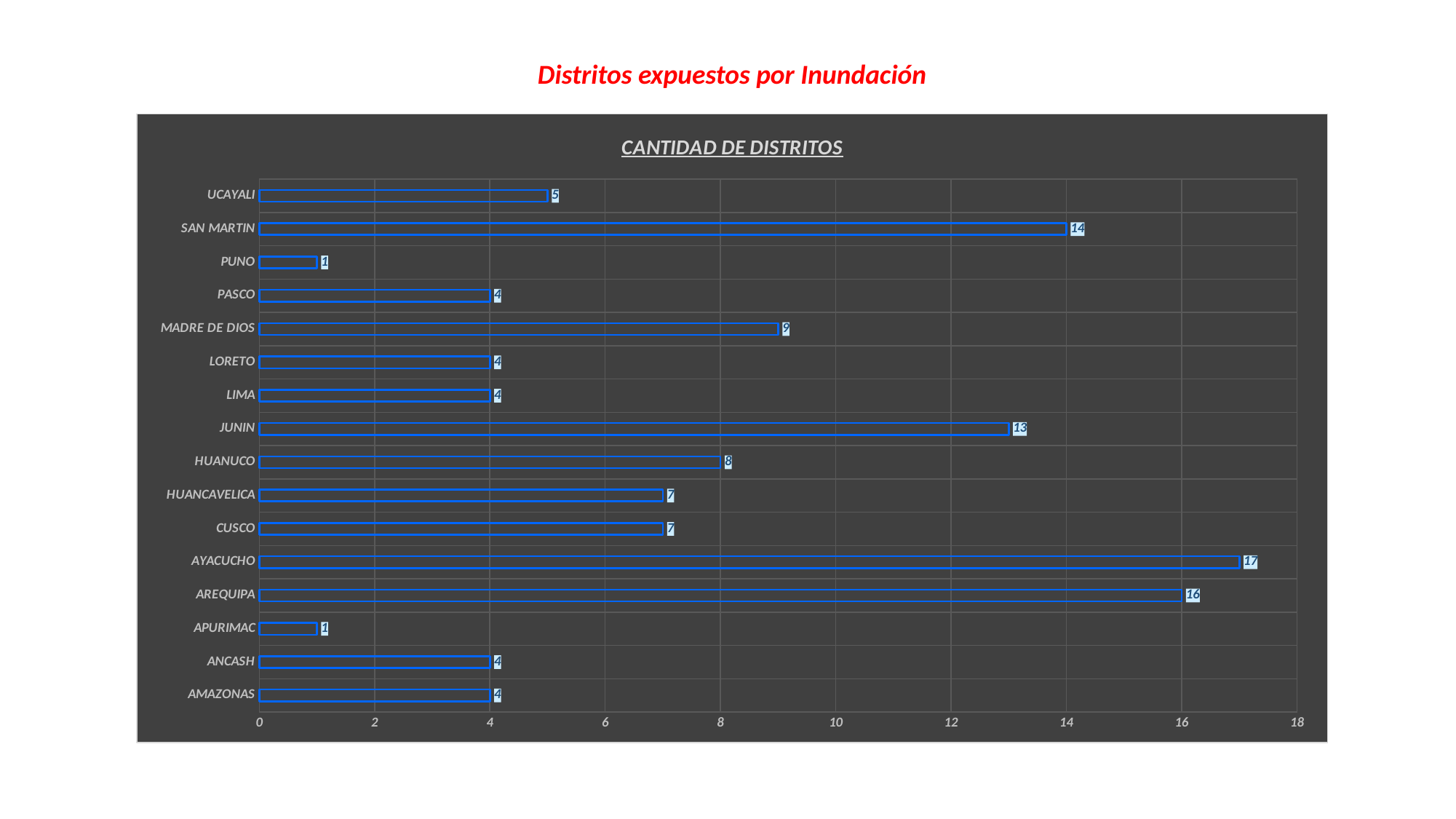
Which category has the highest value? AYACUCHO What is the value for MADRE DE DIOS? 9 What is the title of the chart? CANTIDAD DE DISTRITOS Which is larger, the value for SAN MARTIN or the value for JUNIN? SAN MARTIN What is the value for HUANUCO? 8 What is the value for SAN MARTIN? 14 How many categories are shown on the chart? 16 What is the maximum value shown on the x axis? 18 What is the difference between the values for JUNIN and UCAYALI? 8 What is the difference between the values for AYACUCHO and AREQUIPA? 1 What kind of chart is shown on the slide? Bar chart Which is larger, the value for HUANCAVELICA or the value for PASCO? HUANCAVELICA